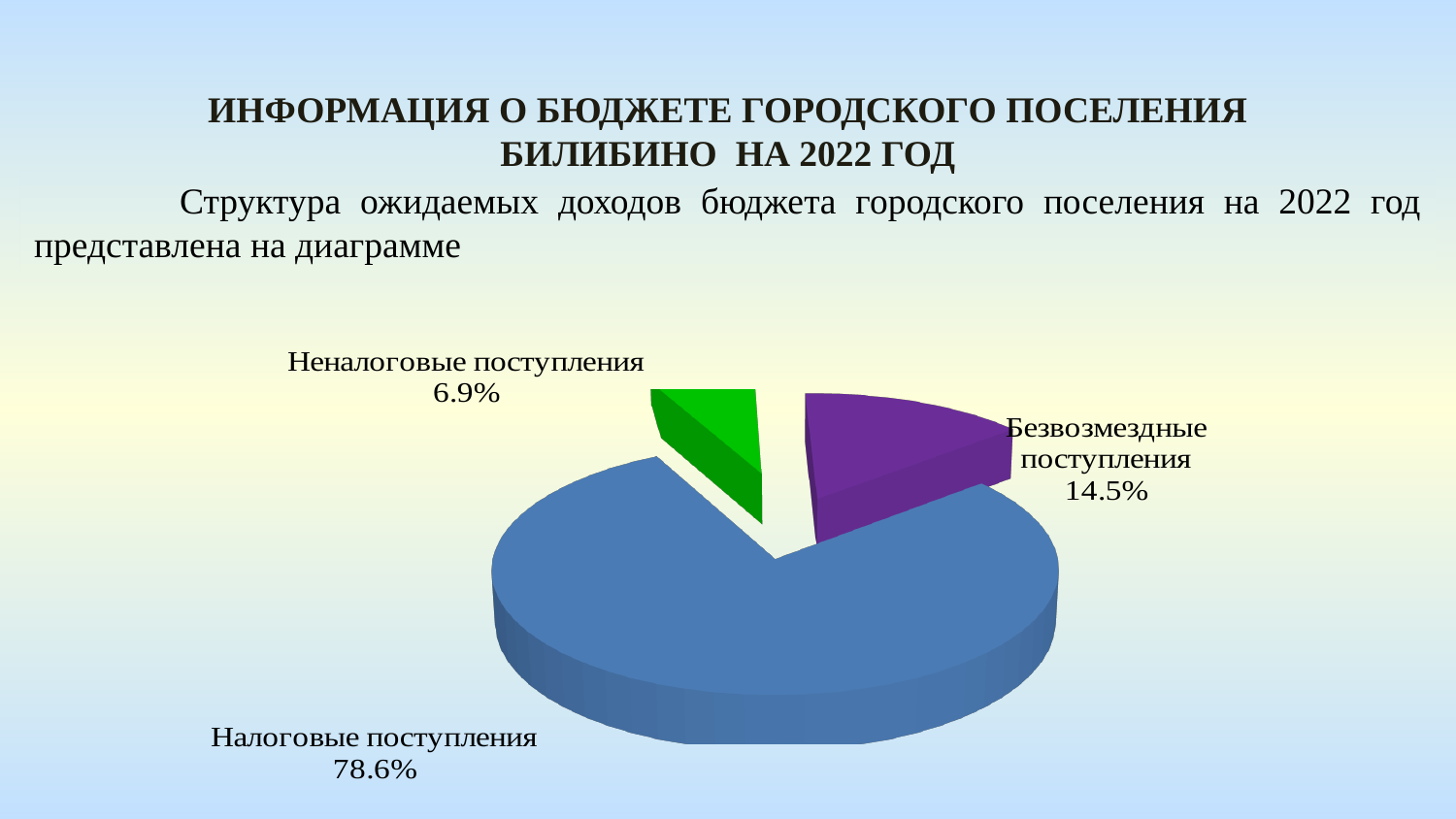
How many slices does the pie chart have? 3 What share of the pie does Безвозмездные поступления have? 14.5% What colour is the slice for Безвозмездные поступления? purple Which is larger: the share for Безвозмездные поступления or the share for Неналоговые поступления? Безвозмездные поступления What colour is the slice for Неналоговые поступления? green What is the difference in percentage points between Безвозмездные поступления and Неналоговые поступления? 7.6 What is the difference in percentage points between Налоговые поступления and Безвозмездные поступления? 64.1 What kind of chart is shown on the slide? pie chart What share of the pie does Налоговые поступления have? 78.6% Which category has the largest share of the pie? Налоговые поступления Which category has the smallest share of the pie? Неналоговые поступления What share of the pie does Неналоговые поступления have? 6.9%